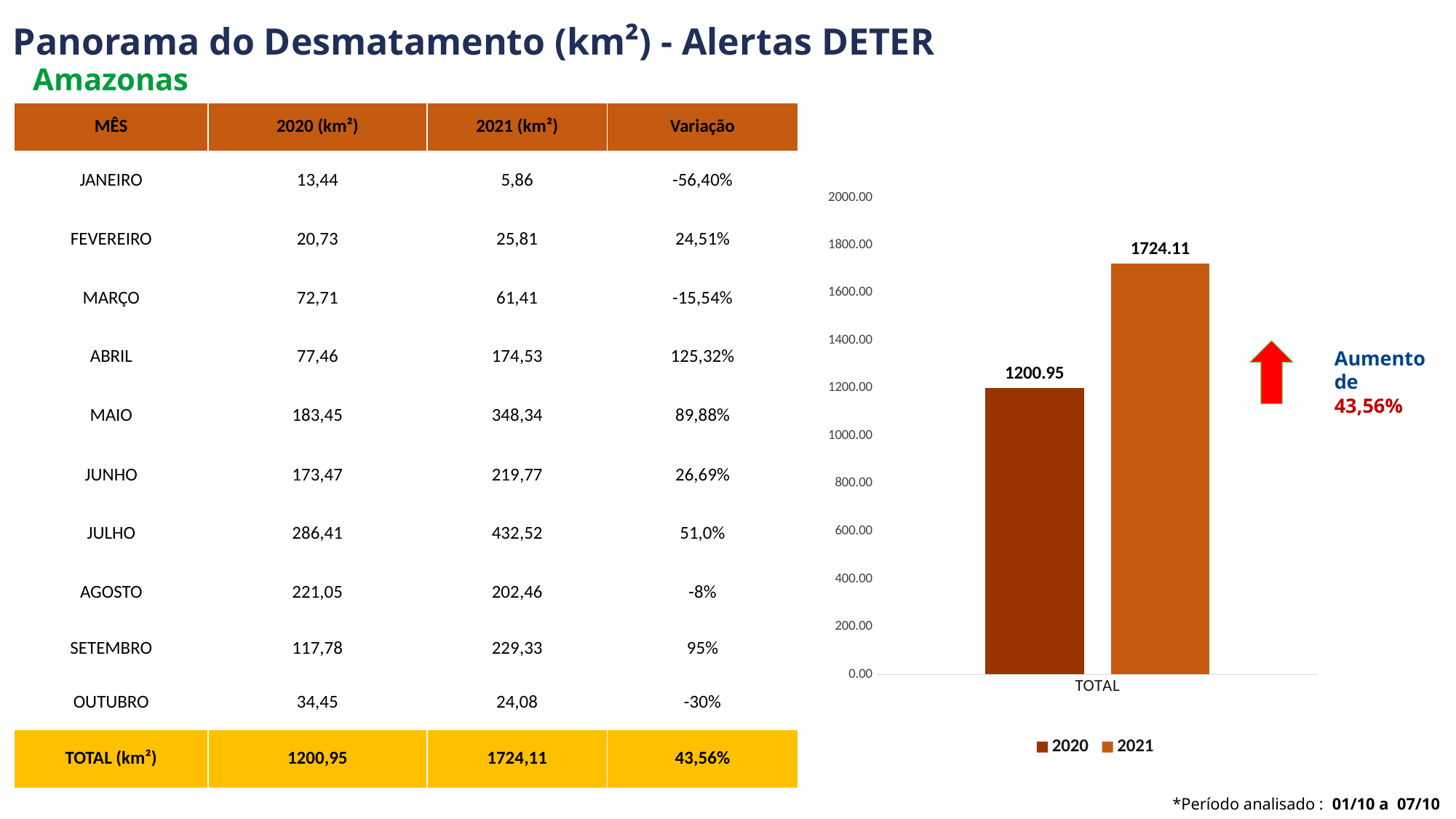
What is the difference between the 2021 bar and the 2020 bar in the chart? 523.16 What kind of chart is shown on the slide? bar chart Is the value of the 2021 bar greater or less than 1600.00? greater Which series has the higher bar in the chart, 2020 or 2021? 2021 Which series has the lowest bar in the chart? 2020 What is the value of the 2021 bar in the chart? 1724.11 How many categories are shown on the x axis of the chart? 1 How many series does the chart legend list? 2 What is the value of the 2020 bar in the chart? 1200.95 What is the label of the category on the x axis of the chart? TOTAL Is the value of the 2020 bar greater or less than 1400.00? less What is the highest tick value shown on the y axis of the chart? 2000.00